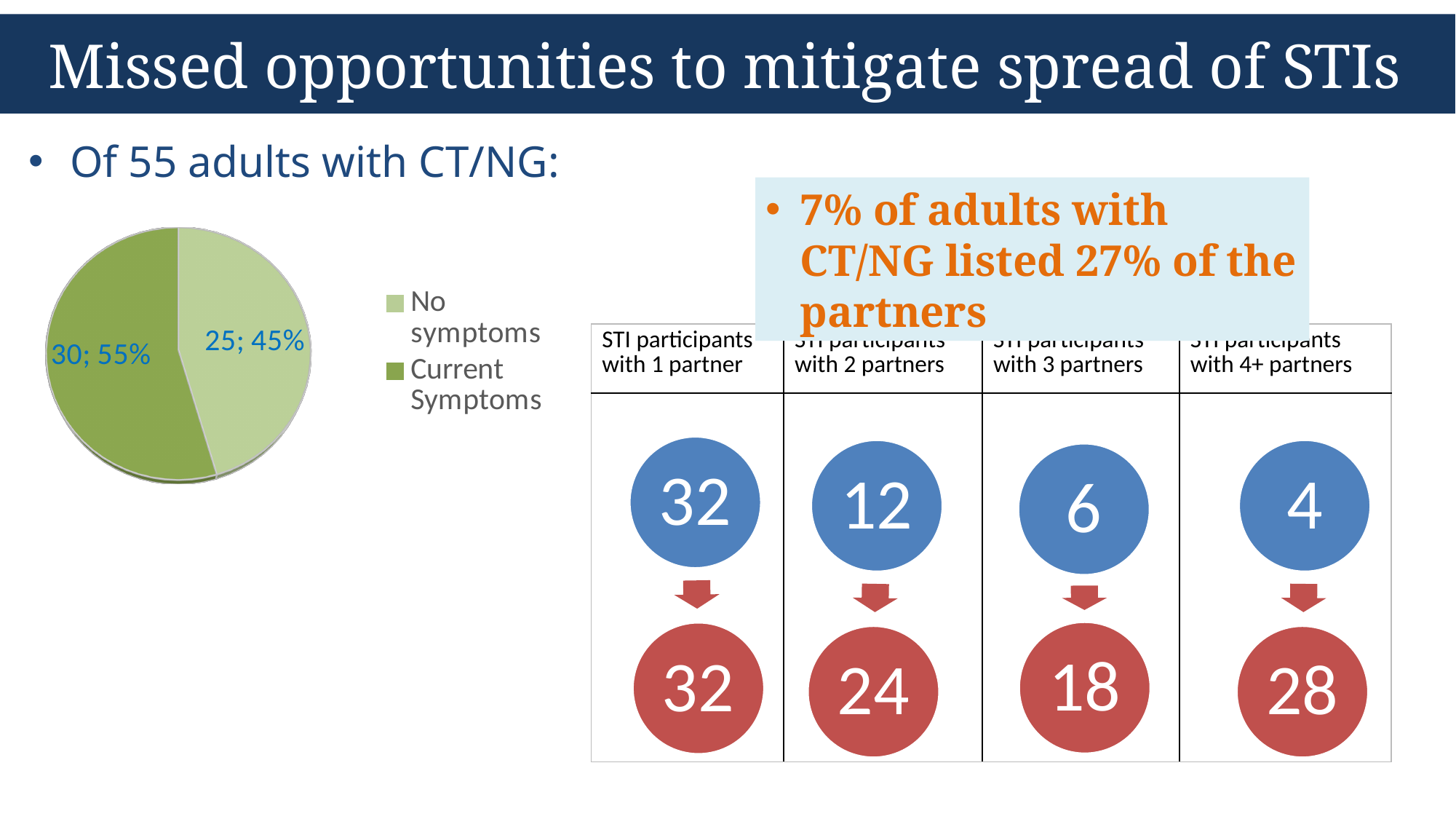
In the pie chart, which slice is larger: No symptoms or Current Symptoms? Current Symptoms How many slices does the pie chart have? 2 In the pie chart, what percentage of adults had current symptoms? 55% In the pie chart, what is the difference in count between Current Symptoms and No symptoms? 5 In the pie chart, how many adults had current symptoms? 30 What kind of chart is shown on the left of the slide? pie chart In the pie chart, which slice is smaller? No symptoms In the pie chart, which legend entry is shown in the darker green colour? Current Symptoms In the pie chart, what percentage of adults had no symptoms? 45% How many entries does the pie chart's legend list? 2 In the pie chart, what is the total number of adults across both slices? 55 In the pie chart, how many adults had no symptoms? 25